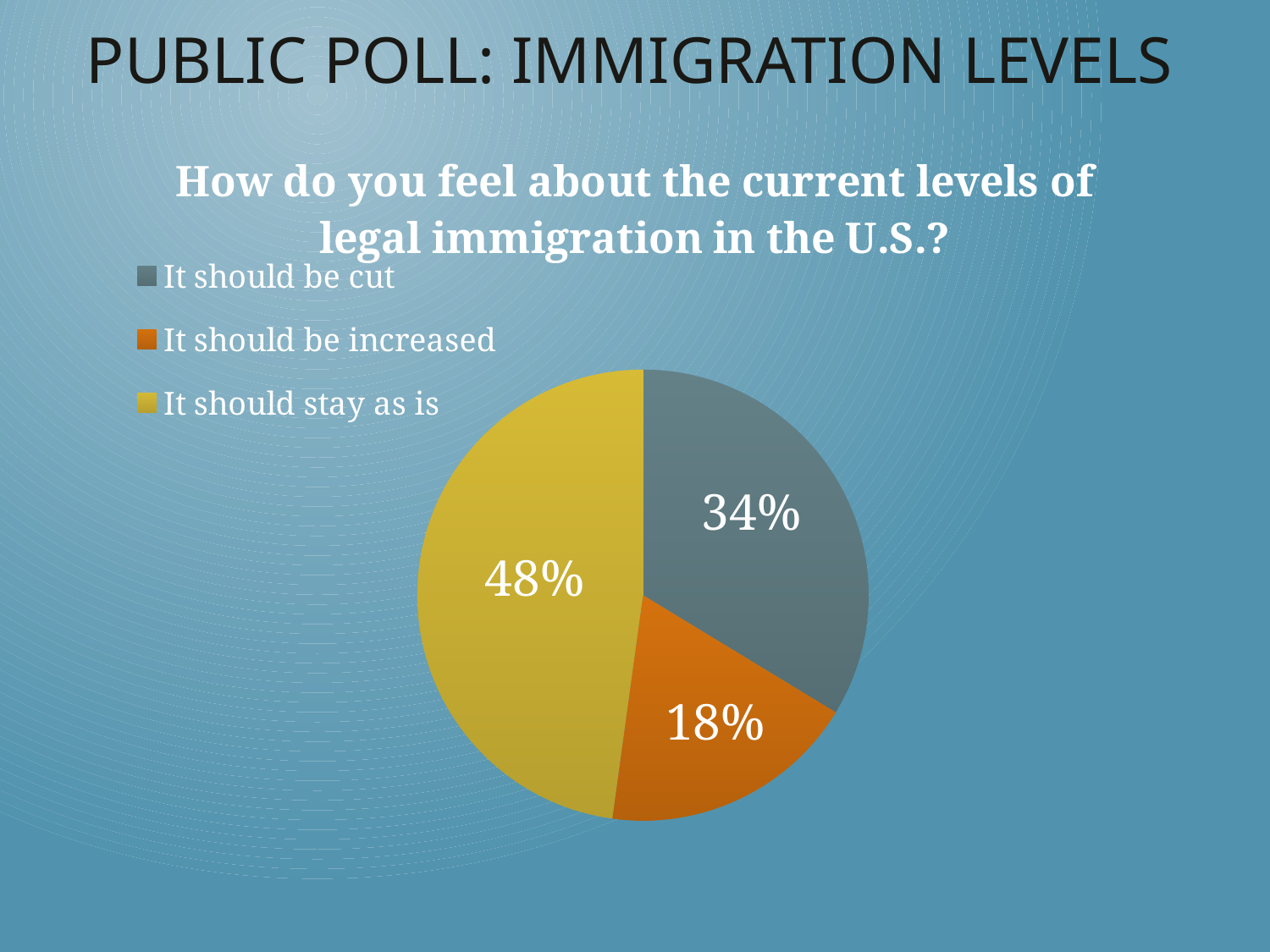
Which response has a larger share: 'It should be cut' or 'It should be increased'? It should be cut What percentage of respondents said legal immigration should stay as is? 48% What is the difference in percentage points between 'It should be cut' and 'It should be increased'? 16 Which response received the largest share of respondents? It should stay as is What is the title of the chart? How do you feel about the current levels of legal immigration in the U.S.? What percentage of respondents said legal immigration should be increased? 18% What is the difference in percentage points between 'It should stay as is' and 'It should be cut'? 14 Which response received the smallest share of respondents? It should be increased What percentage of respondents said legal immigration should be cut? 34% Which colour represents 'It should be increased' in the pie chart? Orange How many response categories are shown in the pie chart? 3 What kind of chart is shown on the slide? Pie chart